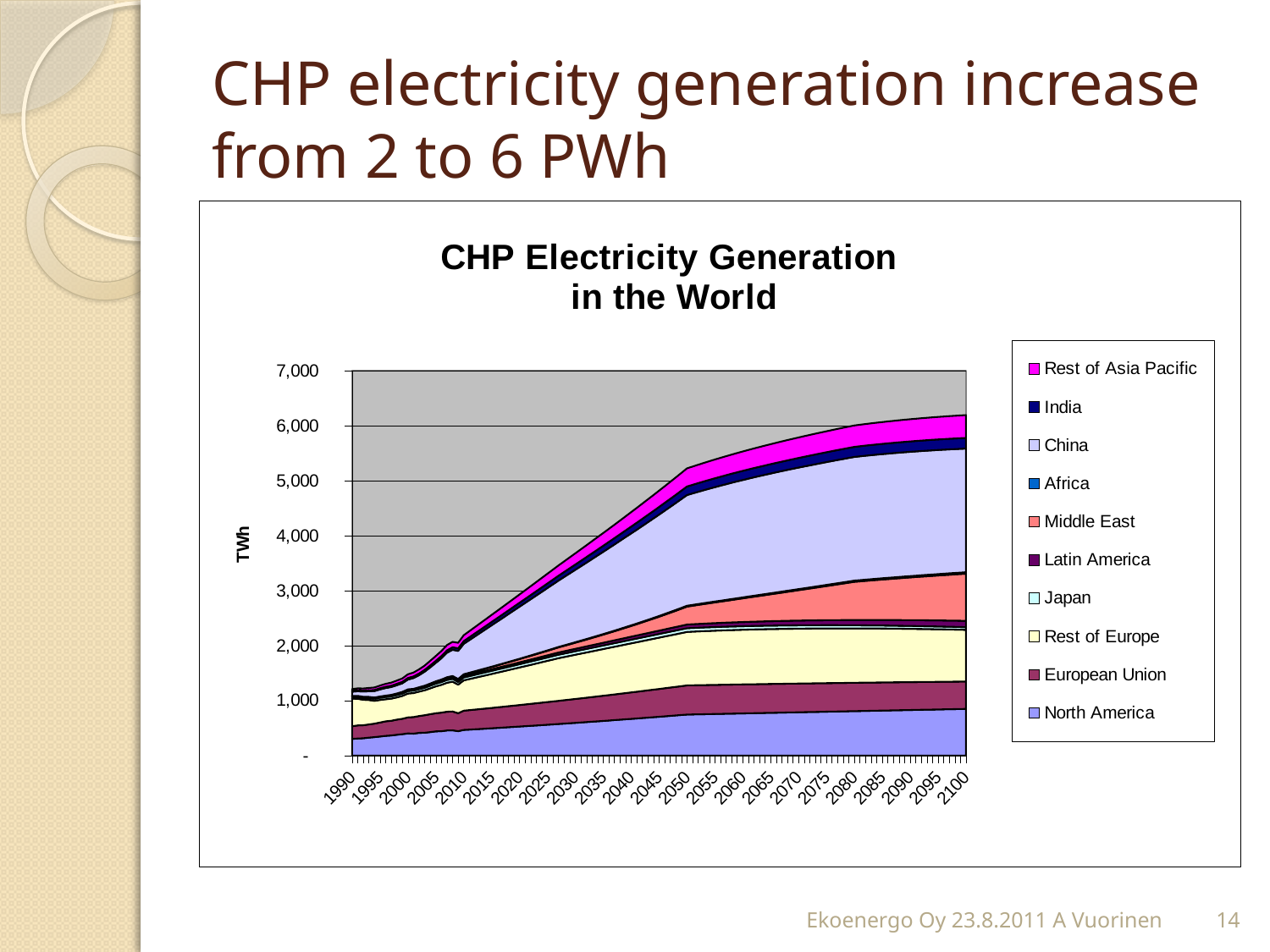
Does the total CHP electricity generation rise or fall from 1990 to 2100? Rise How many year labels are shown on the horizontal axis of the chart? 23 What unit is shown on the vertical axis of the chart? TWh What is the title of the chart? CHP Electricity Generation in the World Is the total CHP electricity generation in 1990 greater or less than 2,000 TWh? less Which region contributes the largest share of CHP electricity generation in 2100? China What kind of chart is shown on the slide? Stacked area chart In 2100, which region contributes more CHP electricity generation: China or Rest of Europe? China Is the total CHP electricity generation in 2030 greater or less than 3,000 TWh? greater Is the total CHP electricity generation in 2050 greater or less than 4,000 TWh? greater How many series does the legend of the chart list? 10